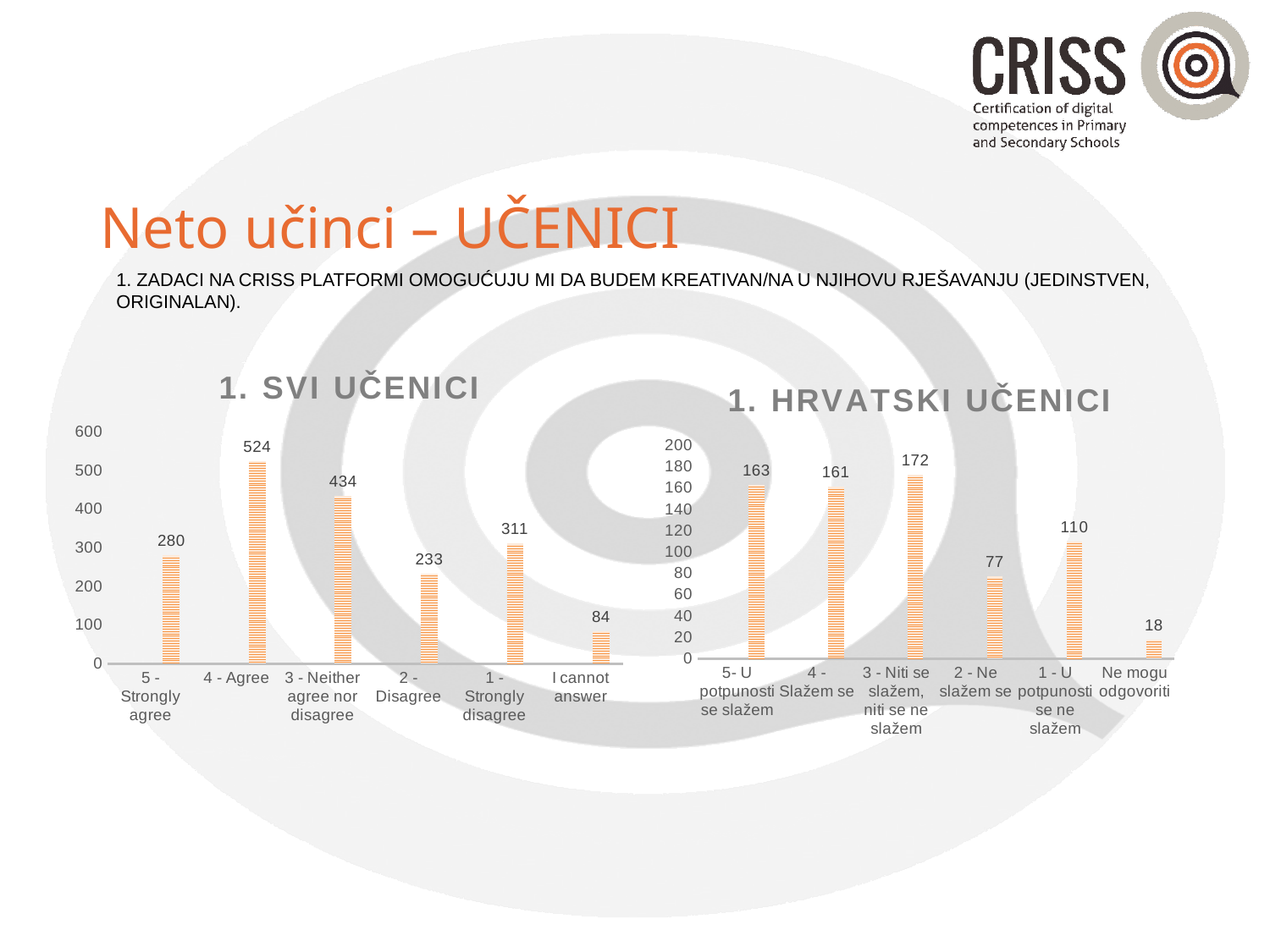
In the "1. SVI UČENICI" chart, which category has the highest value? 4 - Agree In the "1. SVI UČENICI" chart, which is larger: "5 - Strongly agree" or "1 - Strongly disagree"? 1 - Strongly disagree What type of chart is the "1. HRVATSKI UČENICI" chart? Bar chart In the "1. HRVATSKI UČENICI" chart, which category has the lowest value? Ne mogu odgovoriti In the "1. SVI UČENICI" chart, what is the difference between "4 - Agree" and "3 - Neither agree nor disagree"? 90 In the "1. HRVATSKI UČENICI" chart, what is the difference between "1 - U potpunosti se ne slažem" and "Ne mogu odgovoriti"? 92 What is the title of the chart on the left side of the slide? 1. SVI UČENICI In the "1. SVI UČENICI" chart, what is the value for "I cannot answer"? 84 In the "1. HRVATSKI UČENICI" chart, what is the value for "3 - Niti se slažem, niti se ne slažem"? 172 How many categories are shown in the "1. SVI UČENICI" chart? 6 In the "1. SVI UČENICI" chart, what is the value for "4 - Agree"? 524 In the "1. HRVATSKI UČENICI" chart, what is the value for "2 - Ne slažem se"? 77